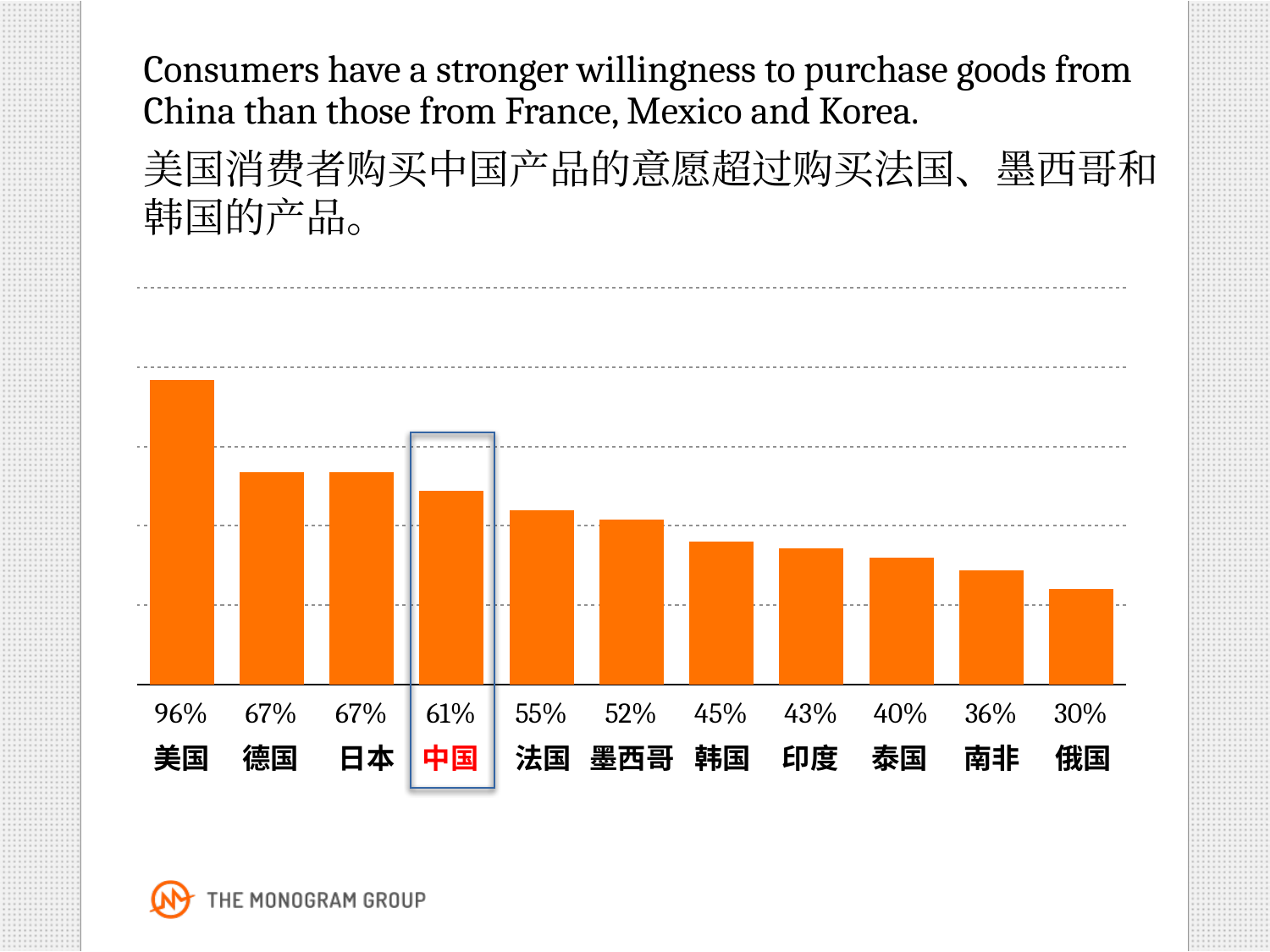
Which category has the highest value? 美国 What is the difference between the values for 美国 and 中国? 35% Which category has the lowest value? 俄国 Which is larger, the value for 法国 or the value for 印度? 法国 What is the value for 中国 (China)? 61% Which category label is highlighted in red and outlined with a box? 中国 What is the value for 墨西哥 (Mexico)? 52% What is the difference between the values for 中国 and 韩国? 16% Which two categories share the same value of 67%? 德国 and 日本 How many categories are shown in the chart? 11 What kind of chart is shown on the slide? Bar chart Do the values rise or fall from left to right along the x axis? Fall